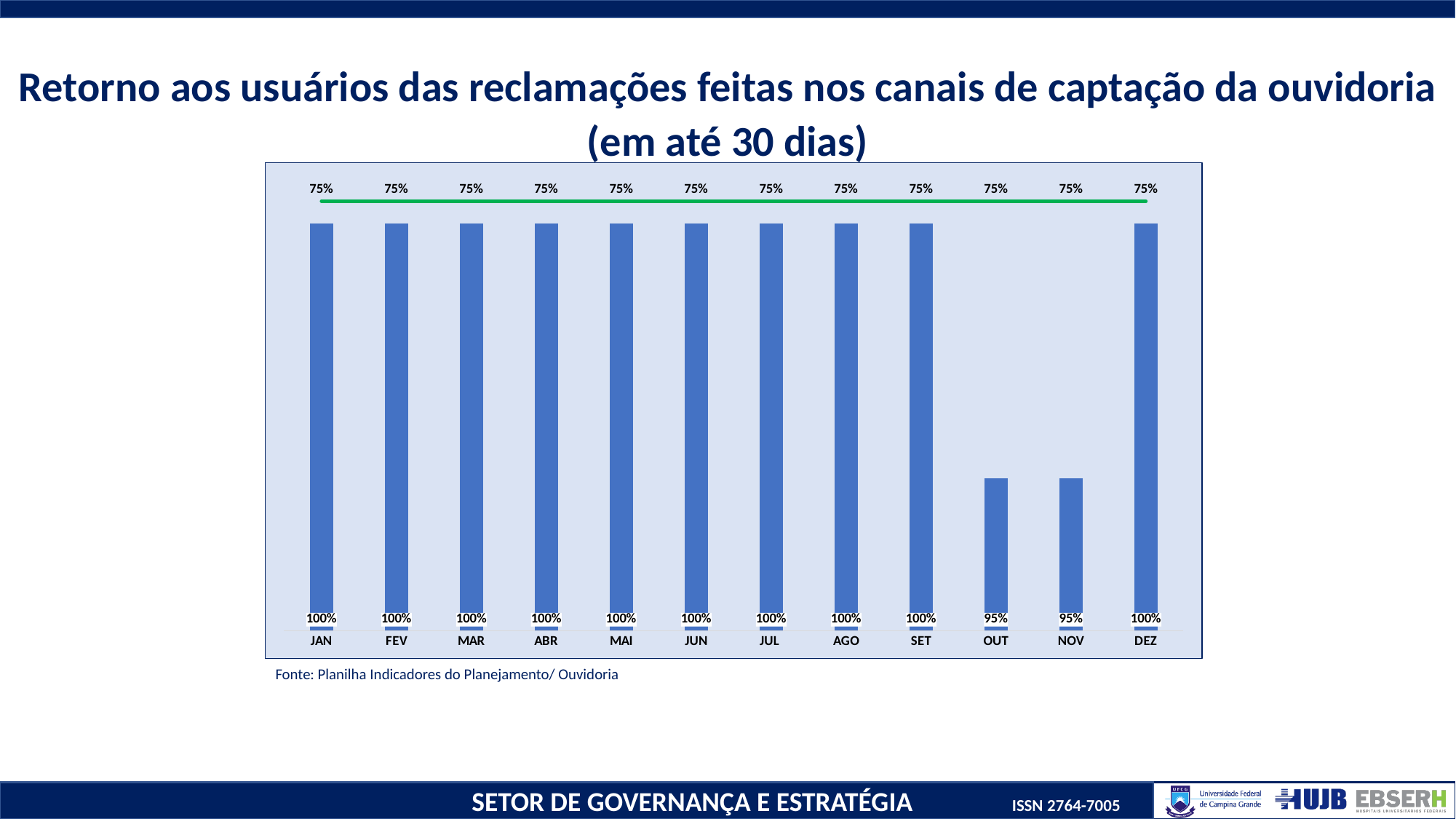
Which is larger, the value for DEZ or the value for NOV? DEZ What is the value for JAN? 100% What kind of chart is this? Combination bar and line chart What is the value for OUT? 95% What is the value for NOV? 95% How many months are shown on the x axis? 12 What is the source cited below the chart? Planilha Indicadores do Planejamento/ Ouvidoria What is the difference between the value for SET and the value for OUT? 5% Which months have the lowest bar value? OUT and NOV What is the difference between the bar value for JUN and the target line value for JUN? 25% Is the value for OUT greater or less than the 75% target line? greater What is the value of the green target line for each month? 75%